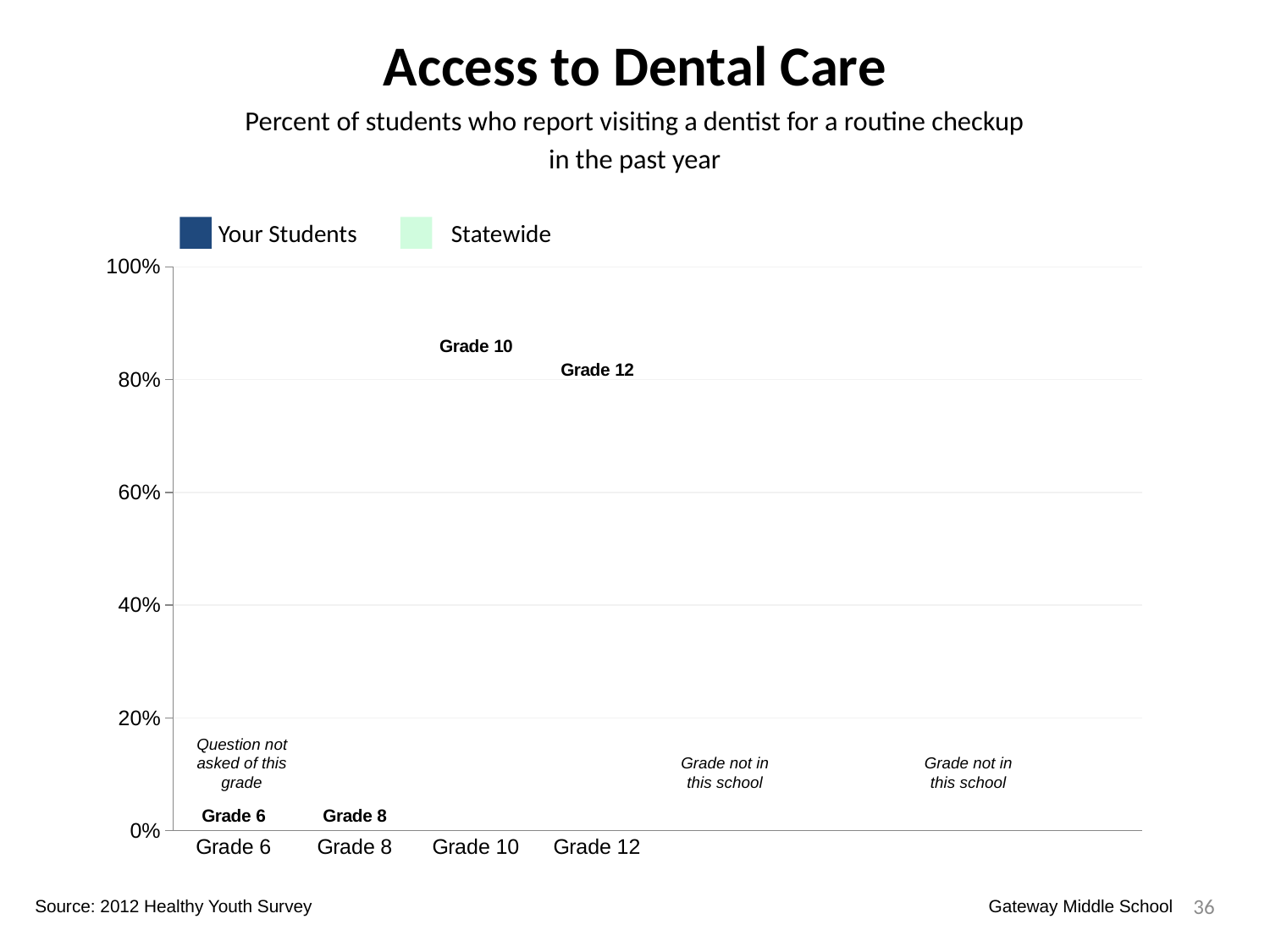
What is the title of the chart? Access to Dental Care What are the two series named in the legend? Your Students and Statewide What is the highest value shown on the y axis? 100% Which grade is annotated with 'Question not asked of this grade'? Grade 6 How many series does the legend list? 2 How many grade categories are labelled along the x axis? 4